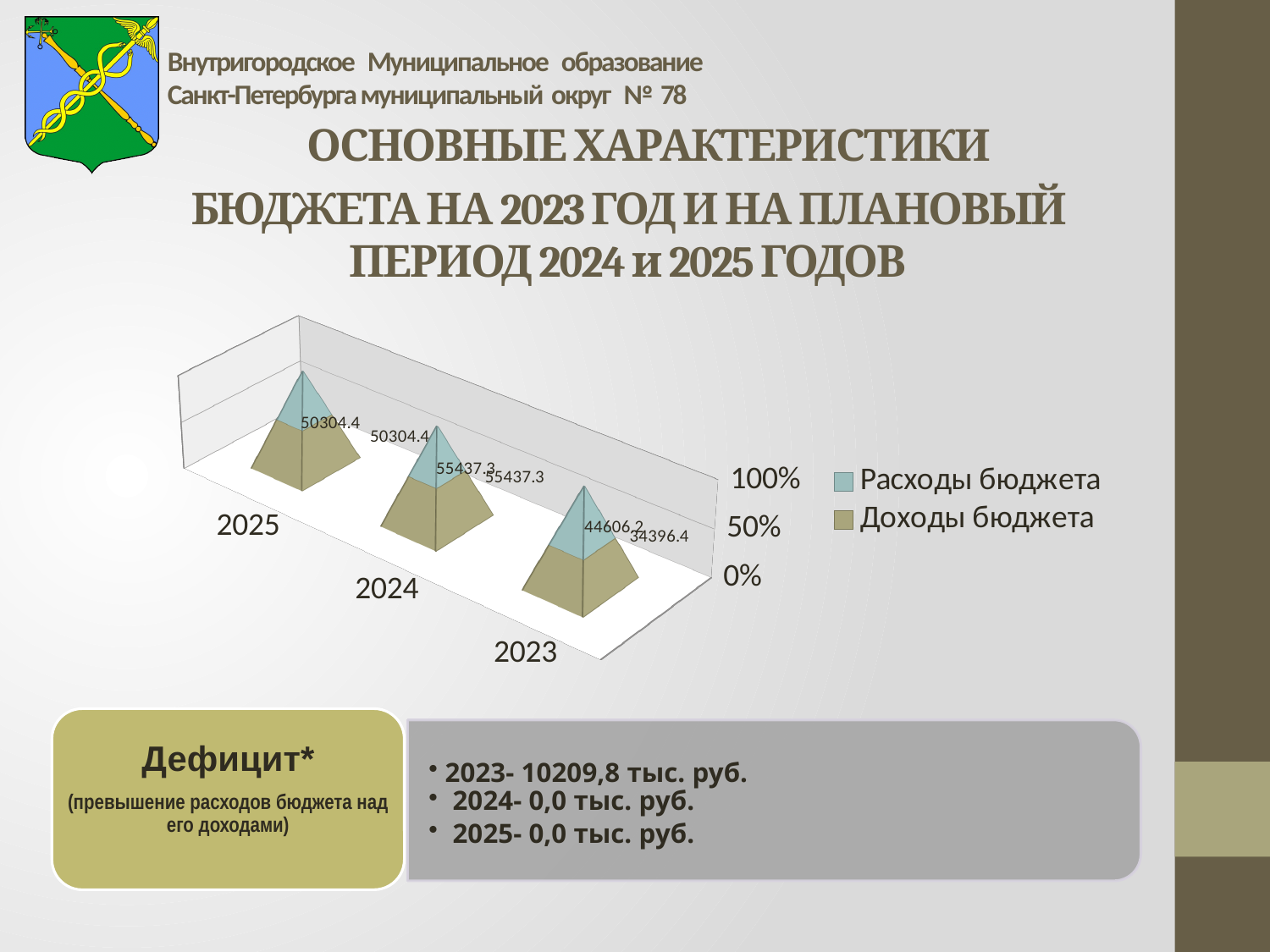
What is the value of Расходы бюджета for 2023? 44606.2 What is the value of Доходы бюджета for 2024? 55437.3 What are the two series named in the legend? Расходы бюджета, Доходы бюджета How many years (categories) are shown on the chart? 3 How many series does the legend list? 2 What is the value of Расходы бюджета for 2025? 50304.4 In which year is Доходы бюджета the lowest? 2023 What is the value of Доходы бюджета for 2023? 34396.4 Which series is shown in the light blue (teal) colour? Расходы бюджета For 2023, which is larger: Расходы бюджета or Доходы бюджета? Расходы бюджета In which year is Доходы бюджета the highest? 2024 What is the difference between Расходы бюджета and Доходы бюджета for 2023? 10209.8